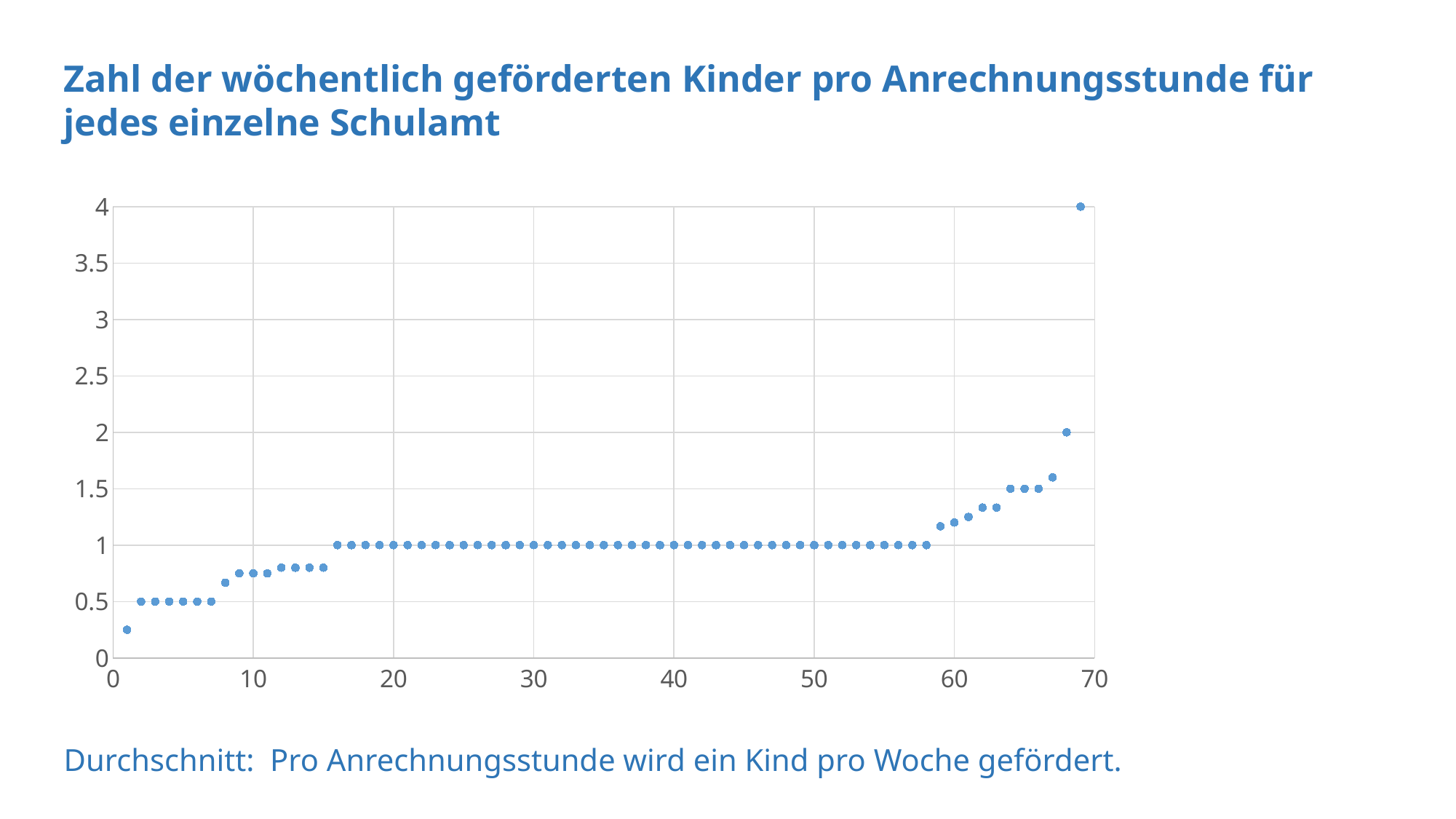
What is the value of the point at x = 69? 4 What is the highest value plotted on the chart? 4 Do the plotted values rise or fall as you move from left to right along the x axis? rise Which point has the larger value, the one at x = 68 or the one at x = 69? x = 69 What is the difference between the values of the points at x = 69 and x = 68? 2 What is the value of the point at x = 30? 1 Is the value of the lowest point greater or less than 0.5? less What is the value of the point at x = 68? 2 What kind of chart is shown on the slide? scatter chart Is the value of the point at x = 10 greater or less than 1? less What is the title of the chart? Zahl der wöchentlich geförderten Kinder pro Anrechnungsstunde für jedes einzelne Schulamt Is the value of the point at x = 60 greater or less than 1? greater